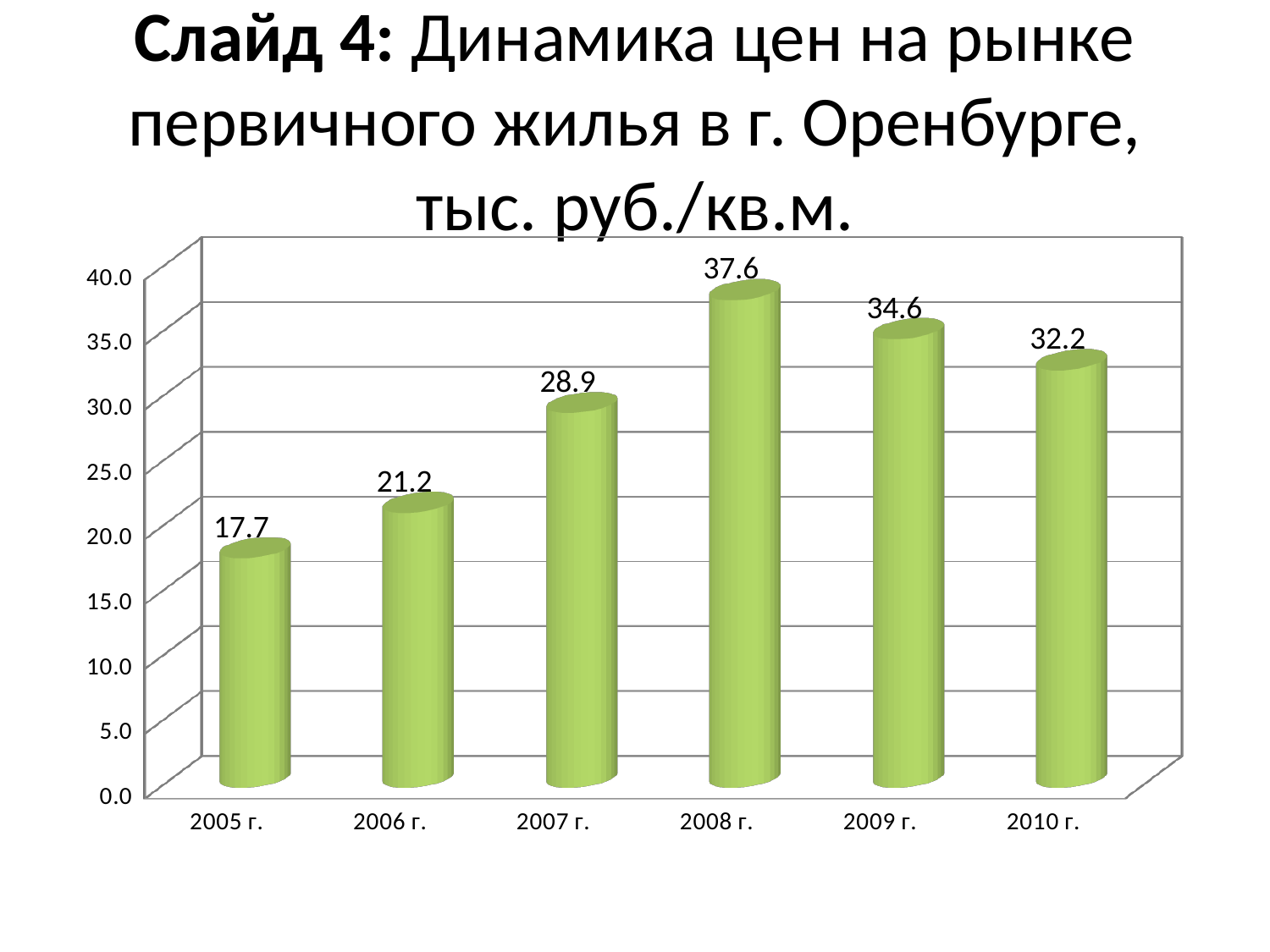
Which year has the lowest value? 2005 г. What is the value for 2008 г.? 37.6 Which year has the highest value? 2008 г. What kind of chart is shown on the slide? bar chart What is the value for 2010 г.? 32.2 What is the difference between the values for 2008 г. and 2009 г.? 3.0 Do the values rise or fall from 2005 г. to 2008 г.? rise Is the value for 2007 г. greater or less than 25.0? greater Which is larger, the value for 2009 г. or the value for 2010 г.? 2009 г. What is the value for 2005 г.? 17.7 How many years are shown on the x axis? 6 What is the difference between the values for 2007 г. and 2006 г.? 7.7